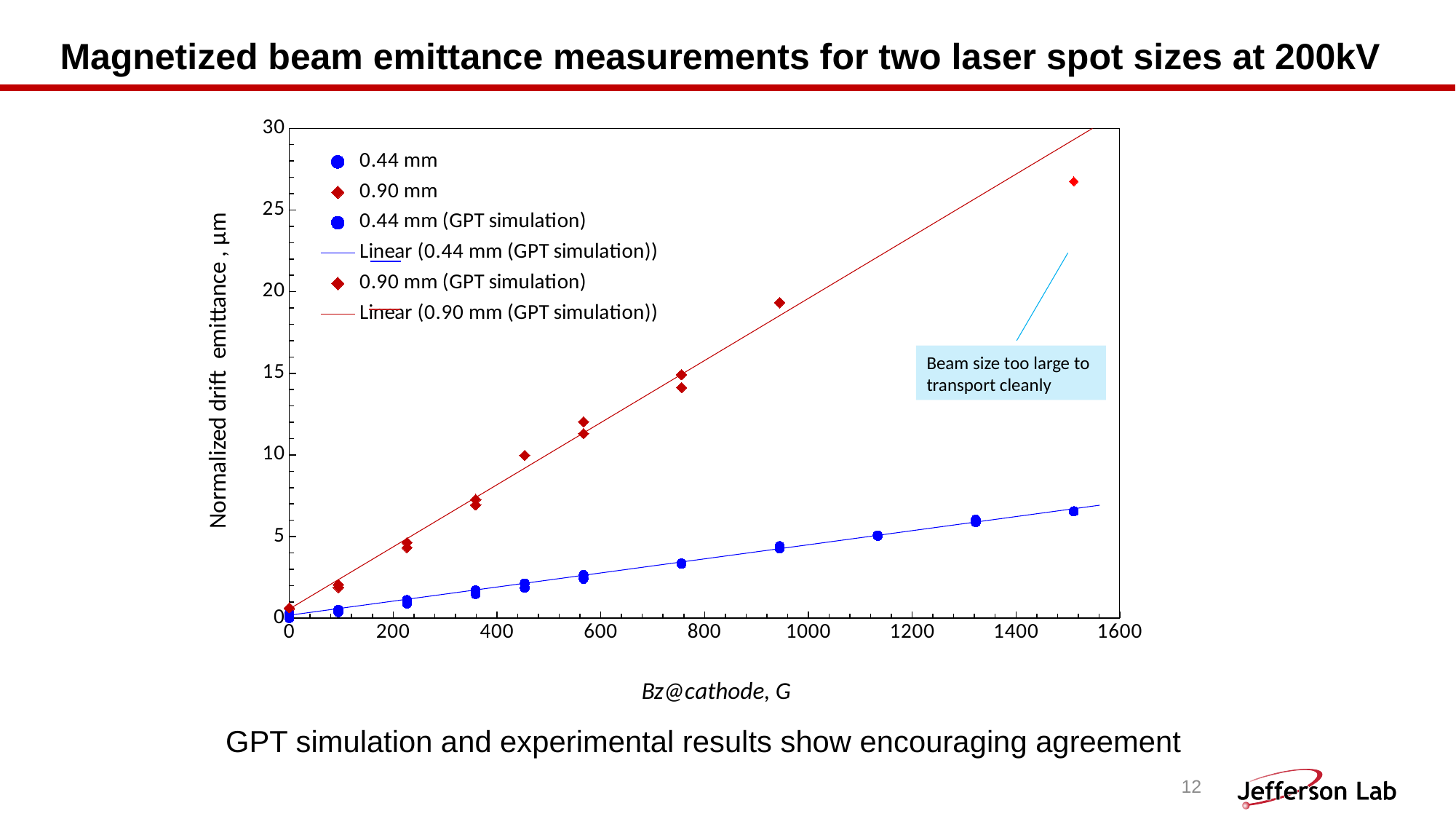
Which laser spot size series reaches the highest normalized drift emittance? 0.90 mm Is the 0.44 mm value at about 1500 G greater or less than 10? less Is the 0.90 mm value at about 450 G greater or less than 5? greater What kind of chart is shown on the slide? scatter chart What does the callout box on the chart say? Beam size too large to transport cleanly Is the 0.90 mm value at about 1500 G greater or less than 25? greater Do the 0.90 mm emittance values rise or fall as Bz@cathode increases? rise At about 950 G, which series has the higher emittance, 0.44 mm or 0.90 mm? 0.90 mm How many series does the legend list? 6 What is the label of the y axis? Normalized drift emittance, μm